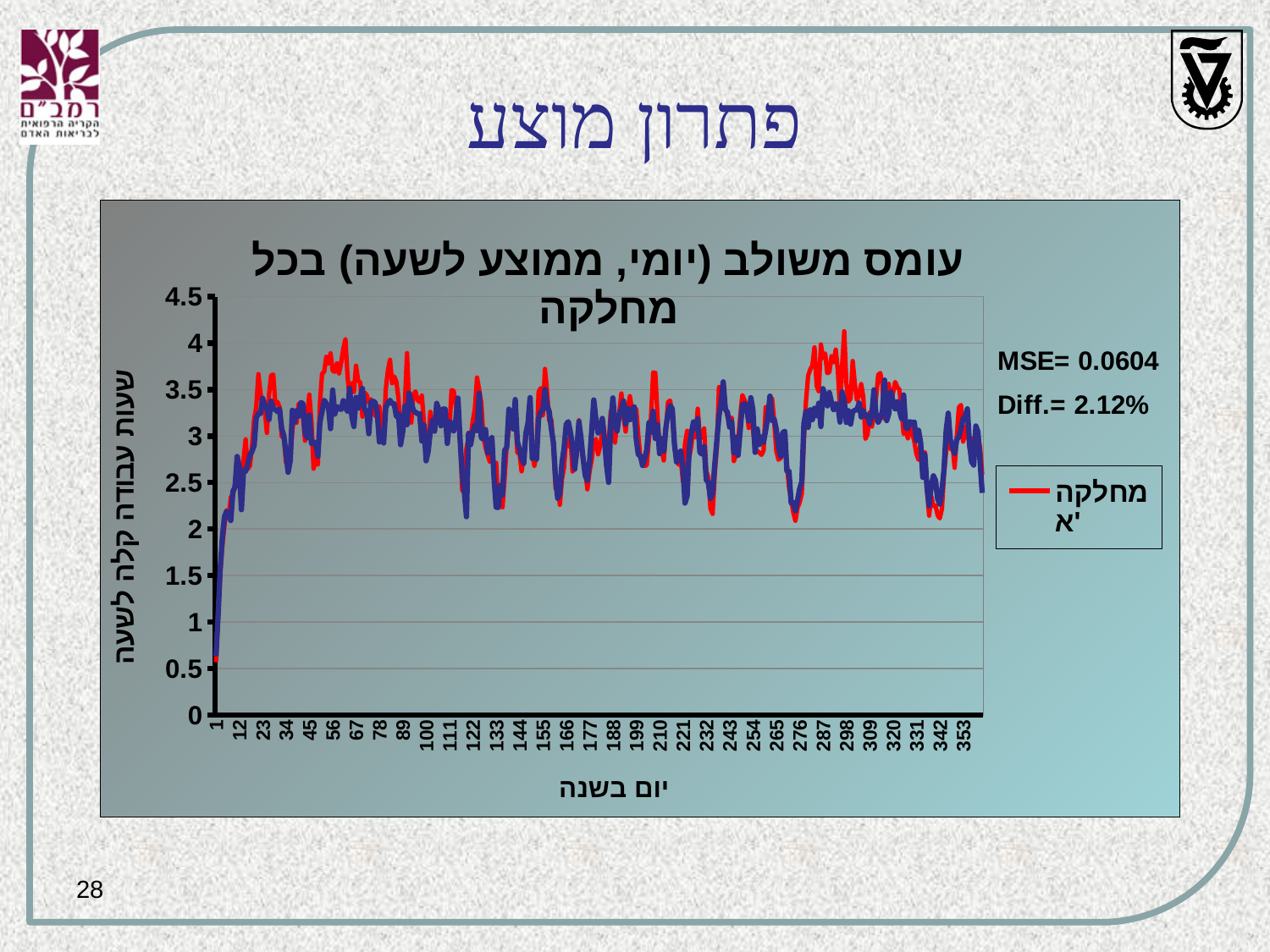
What is the x-axis title of the chart? יום בשנה What is the highest tick value shown on the y axis? 4.5 How many series does the chart's legend list? 1 Do the values rise or fall between day 1 and day 23? rise Is the peak of the red line near day 298 greater or less than 3.5? greater What kind of chart is shown on the slide? line chart What is the MSE value printed next to the chart? 0.0604 Is the value of the red line at day 1 greater or less than 1? less What is the Diff. value printed next to the chart? 2.12% What is the title of the chart? עומס משולב (יומי, ממוצע לשעה) בכל מחלקה Is the value of the red line near day 276 greater or less than 2.5? less What is the label of the series shown in the legend? מחלקה א'